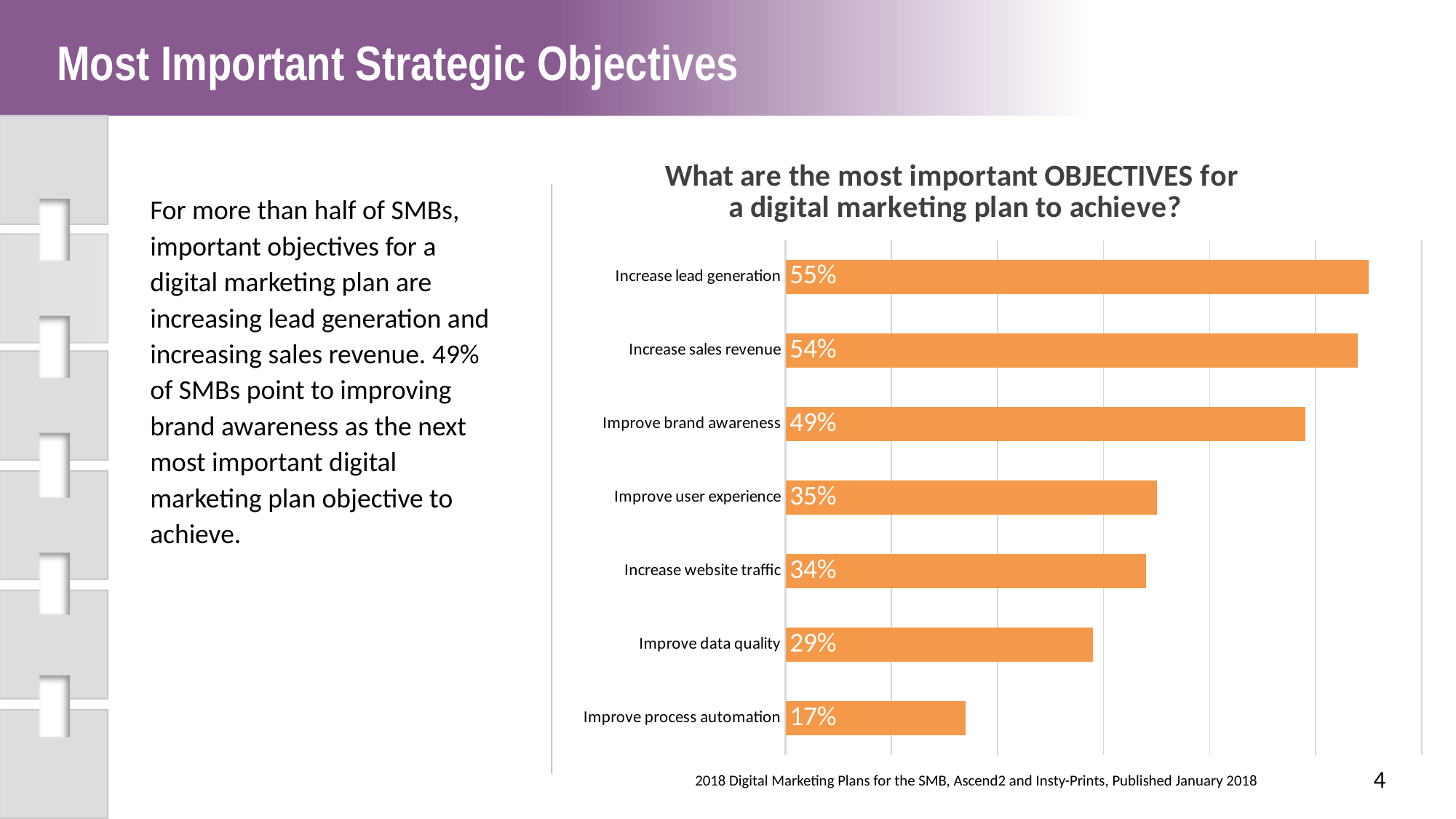
What is the difference in percentage points between 'Increase website traffic' and 'Improve process automation'? 17 What is the title of the chart? What are the most important OBJECTIVES for a digital marketing plan to achieve? What is the difference in percentage points between 'Increase sales revenue' and 'Improve user experience'? 19 What colour are the bars in the chart? Orange Which objective has the lowest percentage in the chart? Improve process automation How many objectives are listed in the chart? 7 What percentage of SMBs chose 'Increase lead generation' as a most important objective? 55% What is the value shown for 'Improve data quality'? 29% Which has a higher value: 'Improve user experience' or 'Improve data quality'? Improve user experience What type of chart is used on this slide? Bar chart Which objective has the highest percentage in the chart? Increase lead generation What is the value shown for 'Improve brand awareness'? 49%